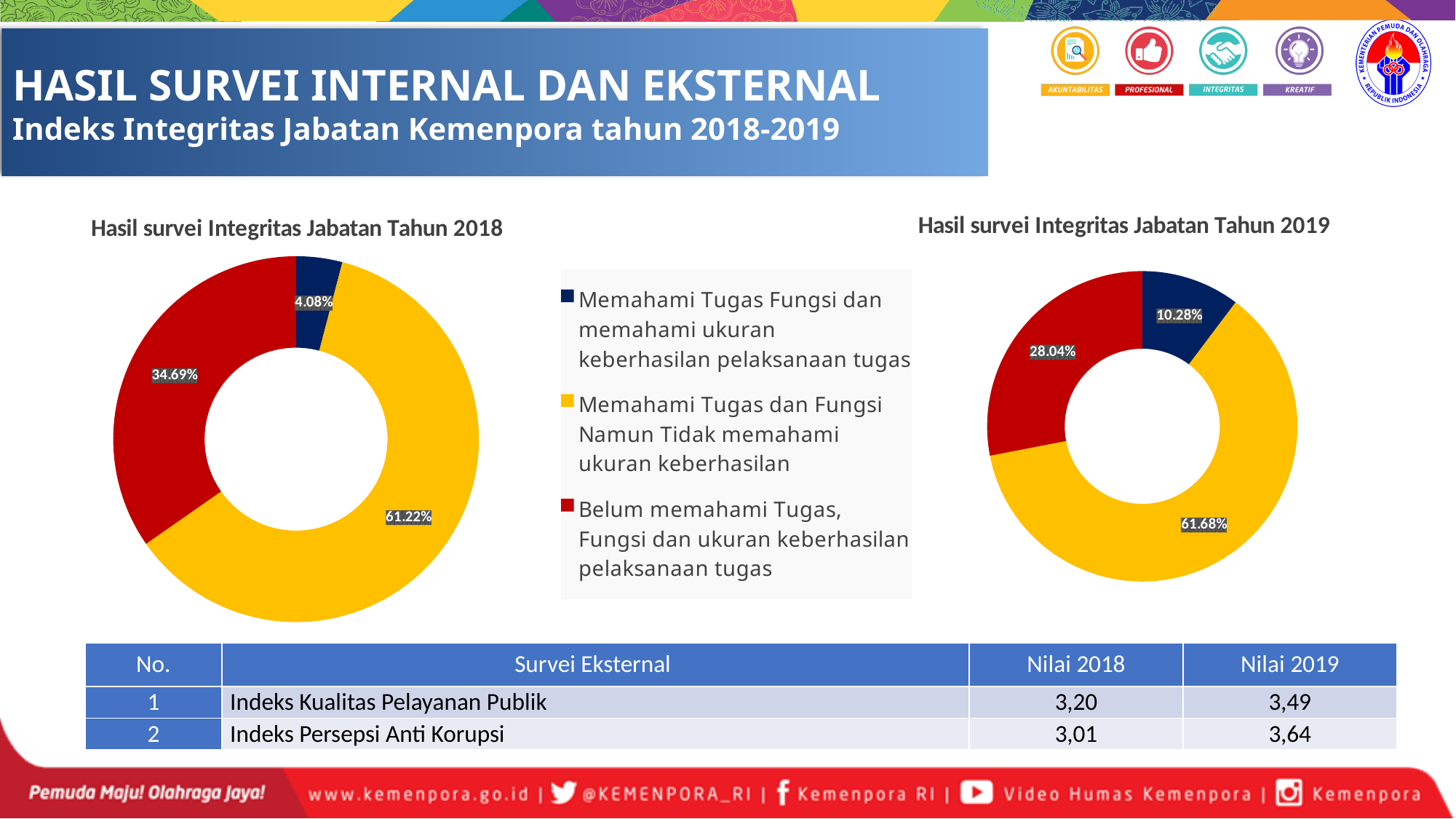
In the 'Hasil survei Integritas Jabatan Tahun 2018' chart, what share is labelled for 'Belum memahami Tugas, Fungsi dan ukuran keberhasilan pelaksanaan tugas'? 34.69% In the 'Hasil survei Integritas Jabatan Tahun 2019' chart, which category has the smallest share? Memahami Tugas Fungsi dan memahami ukuran keberhasilan pelaksanaan tugas What kind of chart is 'Hasil survei Integritas Jabatan Tahun 2018'? Doughnut chart What is the difference between the 'Belum memahami Tugas, Fungsi dan ukuran keberhasilan pelaksanaan tugas' share in the 2018 chart and in the 2019 chart? 6.65% In the 'Hasil survei Integritas Jabatan Tahun 2018' chart, which category has the largest share? Memahami Tugas dan Fungsi Namun Tidak memahami ukuran keberhasilan In the 'Hasil survei Integritas Jabatan Tahun 2019' chart, what share is labelled for 'Memahami Tugas dan Fungsi Namun Tidak memahami ukuran keberhasilan'? 61.68% How many categories does each doughnut chart on the slide show? 3 Which colour represents 'Belum memahami Tugas, Fungsi dan ukuran keberhasilan pelaksanaan tugas' in the legend? Red In the 'Hasil survei Integritas Jabatan Tahun 2018' chart, what share is labelled for 'Memahami Tugas Fungsi dan memahami ukuran keberhasilan pelaksanaan tugas'? 4.08% In the 'Hasil survei Integritas Jabatan Tahun 2019' chart, what share is labelled for 'Memahami Tugas Fungsi dan memahami ukuran keberhasilan pelaksanaan tugas'? 10.28% In the 'Hasil survei Integritas Jabatan Tahun 2019' chart, what is the combined share of the two 'Memahami' categories (10.28% and 61.68%)? 71.96% Is the 'Memahami Tugas Fungsi dan memahami ukuran keberhasilan pelaksanaan tugas' share larger in the 2018 chart or the 2019 chart? 2019